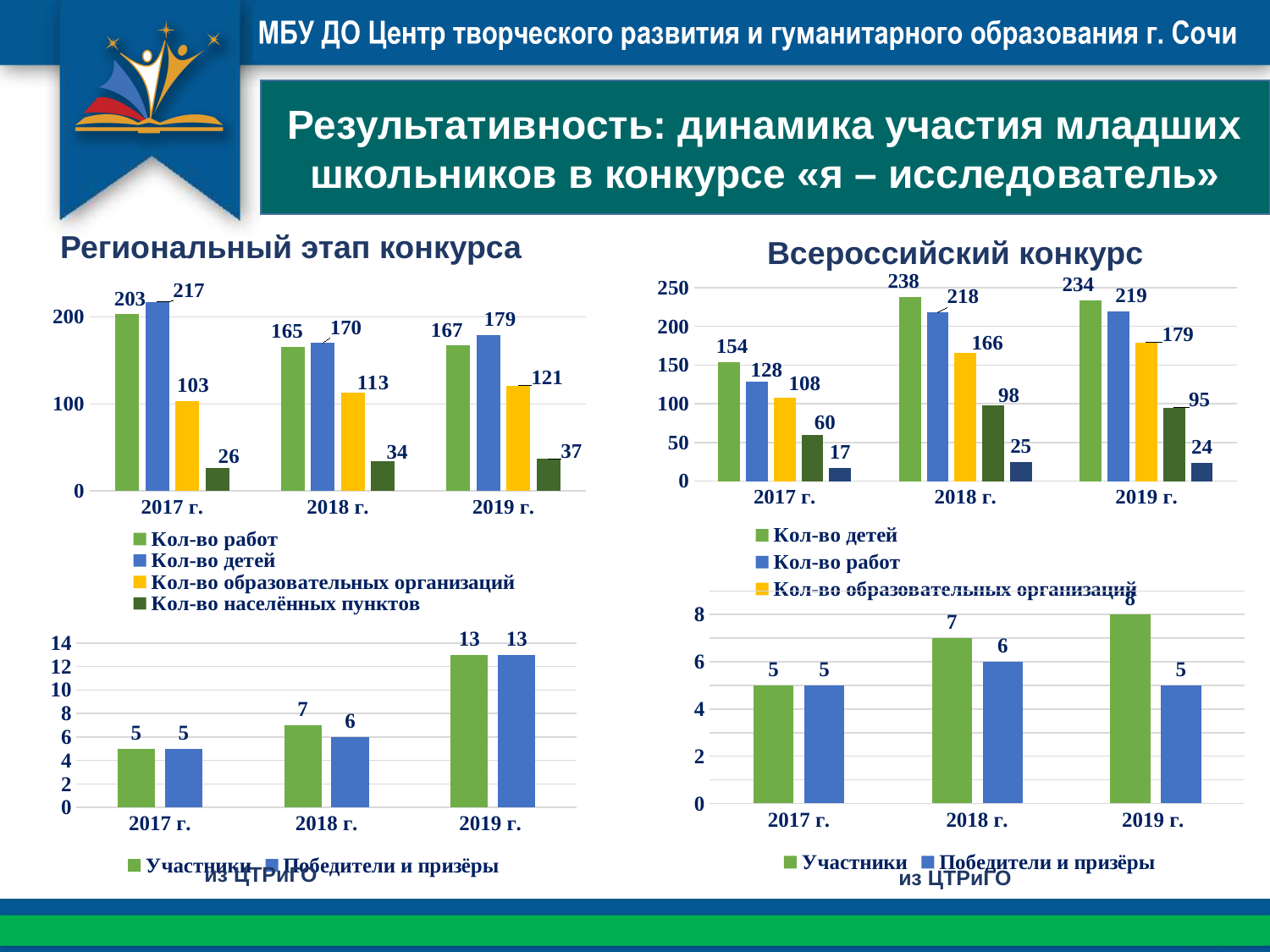
In the top-left chart 'Региональный этап конкурса', what is the difference between 'Кол-во работ' in 2017 г. and 2018 г.? 38 In the top-left chart 'Региональный этап конкурса', how many series does the legend list? 4 In the bottom-left chart, how does the value of 'Участники' change from 2017 г. to 2019 г.? It rises In the top-left chart 'Региональный этап конкурса', what is the value of 'Кол-во населённых пунктов' for 2019 г.? 37 In the top-right chart 'Всероссийский конкурс', is 'Кол-во работ' for 2019 г. greater or less than 200? greater In the bottom-right chart, what is the value of 'Участники' for 2019 г.? 8 In the top-left chart 'Региональный этап конкурса', what is the value of 'Кол-во детей' for 2017 г.? 217 In the top-right chart 'Всероссийский конкурс', what is the value of 'Кол-во детей' for 2018 г.? 238 In the top-right chart 'Всероссийский конкурс', which year has the lowest value for 'Кол-во образовательных организаций'? 2017 г. In the bottom-left chart, what is the value of 'Победители и призёры' for 2018 г.? 6 In the top-right chart 'Всероссийский конкурс', which is larger: 'Кол-во детей' in 2018 г. or in 2019 г.? 2018 г. What type of chart is the bottom-right chart? Bar chart